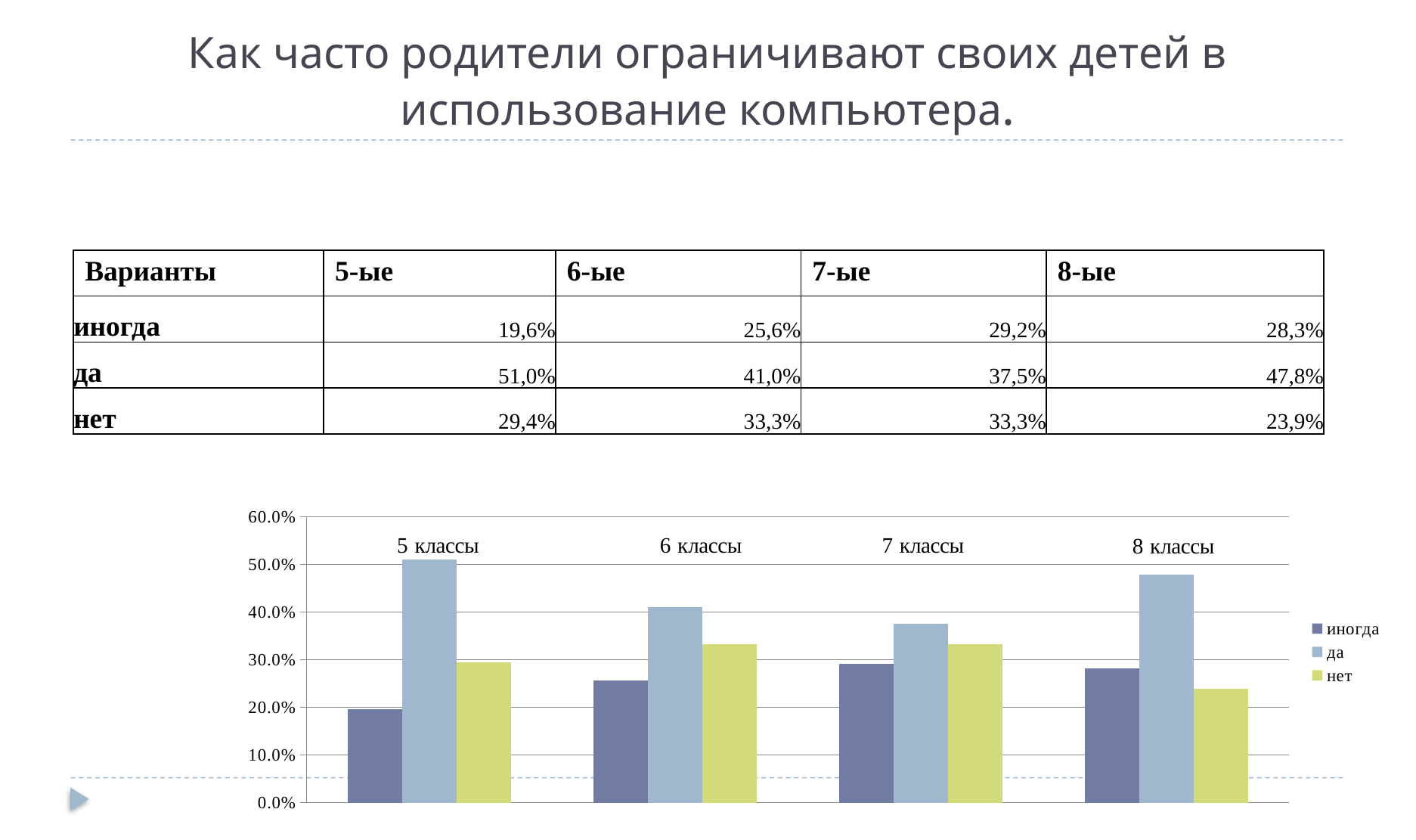
Which class group has the highest value for "да"? 5 классы What is the value of "нет" for 8 классы? 23,9% Which class group has the lowest value for "иногда"? 5 классы How many series does the chart legend list? 3 What is the value of "да" for 5 классы? 51,0% What kind of chart is shown on the slide? bar chart Does the value of "иногда" rise or fall from 5 классы to 7 классы? rises For 8 классы, which is larger: "да" or "нет"? да What is the difference between "да" and "нет" for 5 классы? 21,6% Is the value of "да" for 8 классы greater or less than 40%? greater How many class groups are shown along the x axis of the chart? 4 Which colour represents the "да" series in the chart legend? light blue